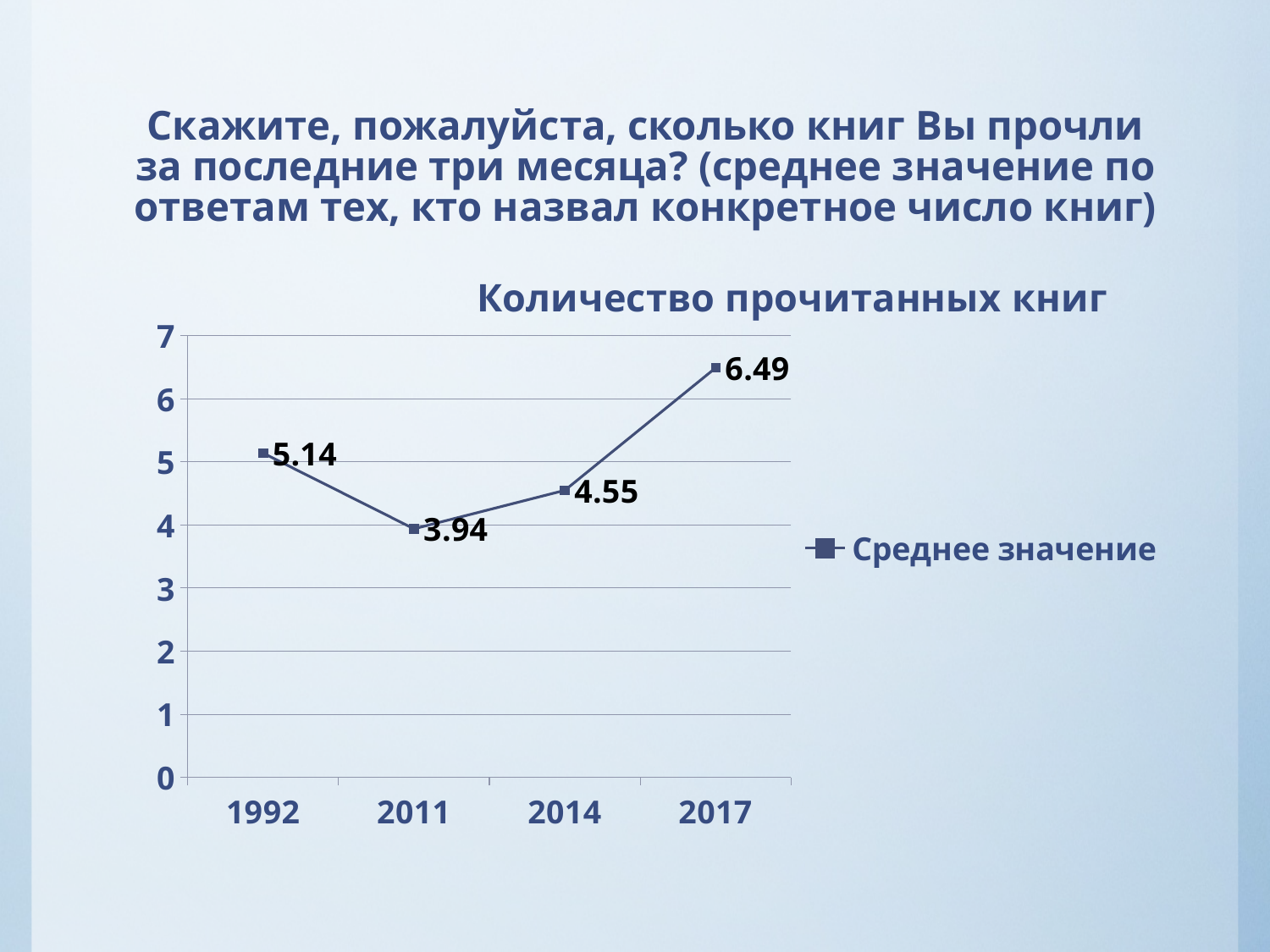
What kind of chart is shown? line chart Which year has the highest value? 2017 What is the difference between the values for 2017 and 1992? 1.35 What is the title of the chart? Количество прочитанных книг What is the value for 2014? 4.55 What is the value for 2011? 3.94 How many years are plotted on the chart? 4 Which is larger, the value for 1992 or the value for 2014? 1992 Which year has the lowest value? 2011 What is the value for 2017? 6.49 What is the value for 1992? 5.14 What is the difference between the values for 2014 and 2011? 0.61